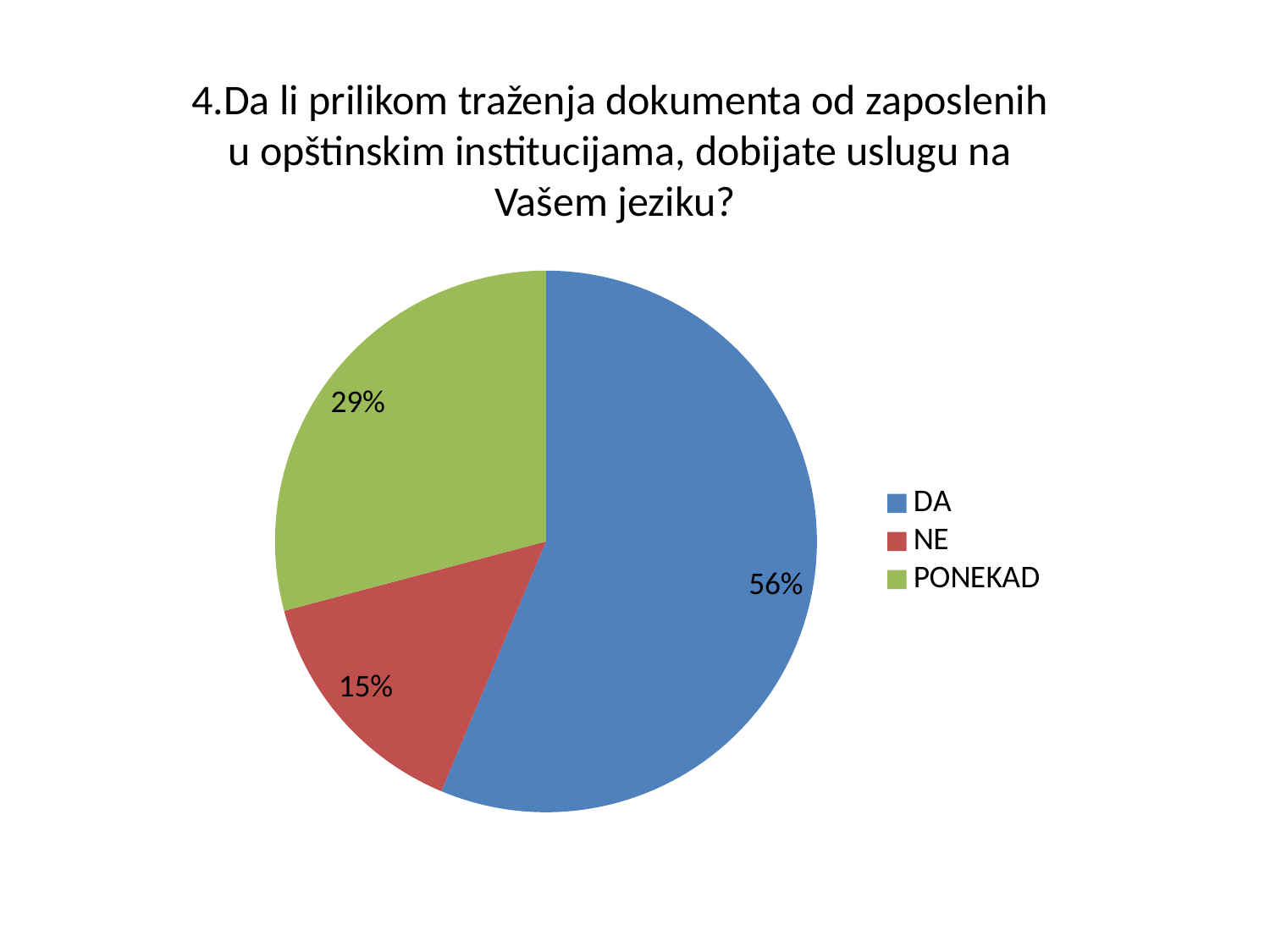
What percentage of the pie is labelled NE? 15% What type of chart is shown on the slide? pie chart What percentage of the pie is labelled PONEKAD? 29% What percentage of the pie is labelled DA? 56% What colour is the DA slice? blue Which slice is larger, PONEKAD or NE? PONEKAD What is the difference in percentage points between the DA and NE slices? 41 How many categories does the legend list? 3 Which category has the largest share of the pie? DA Which category has the smallest share of the pie? NE Which legend entry is shown in green? PONEKAD What is the difference in percentage points between the PONEKAD and NE slices? 14